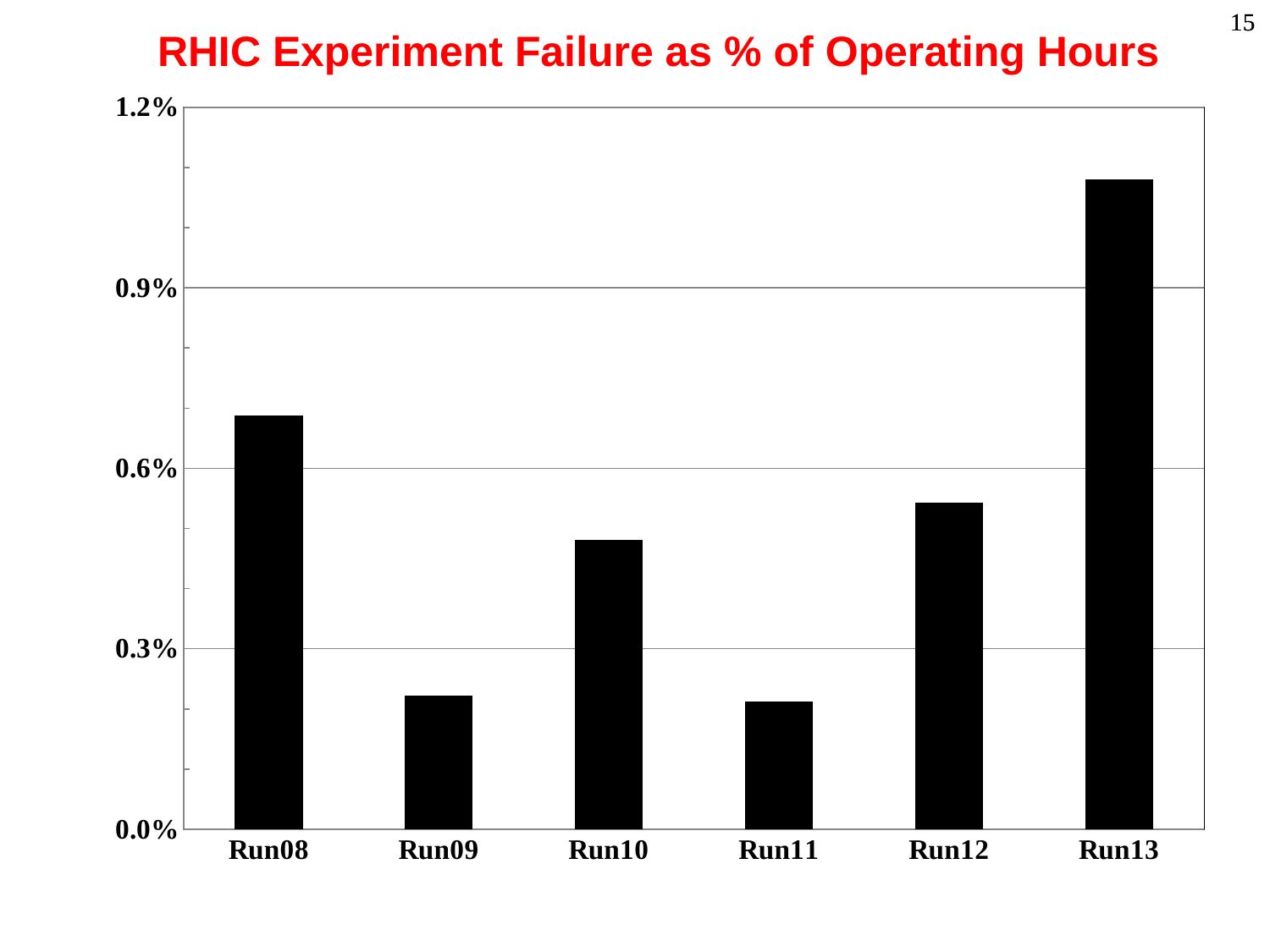
Is the value for Run08 greater or less than 0.6%? greater Is the value for Run13 greater or less than 0.9%? greater How many runs are shown on the x axis of the chart? 6 What type of chart is shown on the slide? bar chart Which is larger, the value for Run08 or the value for Run12? Run08 Which is larger, the value for Run10 or the value for Run11? Run10 What is the title of the chart? RHIC Experiment Failure as % of Operating Hours Is the value for Run12 greater or less than 0.3%? greater Which run has the highest experiment failure percentage? Run13 What is the highest value labelled on the y axis? 1.2%